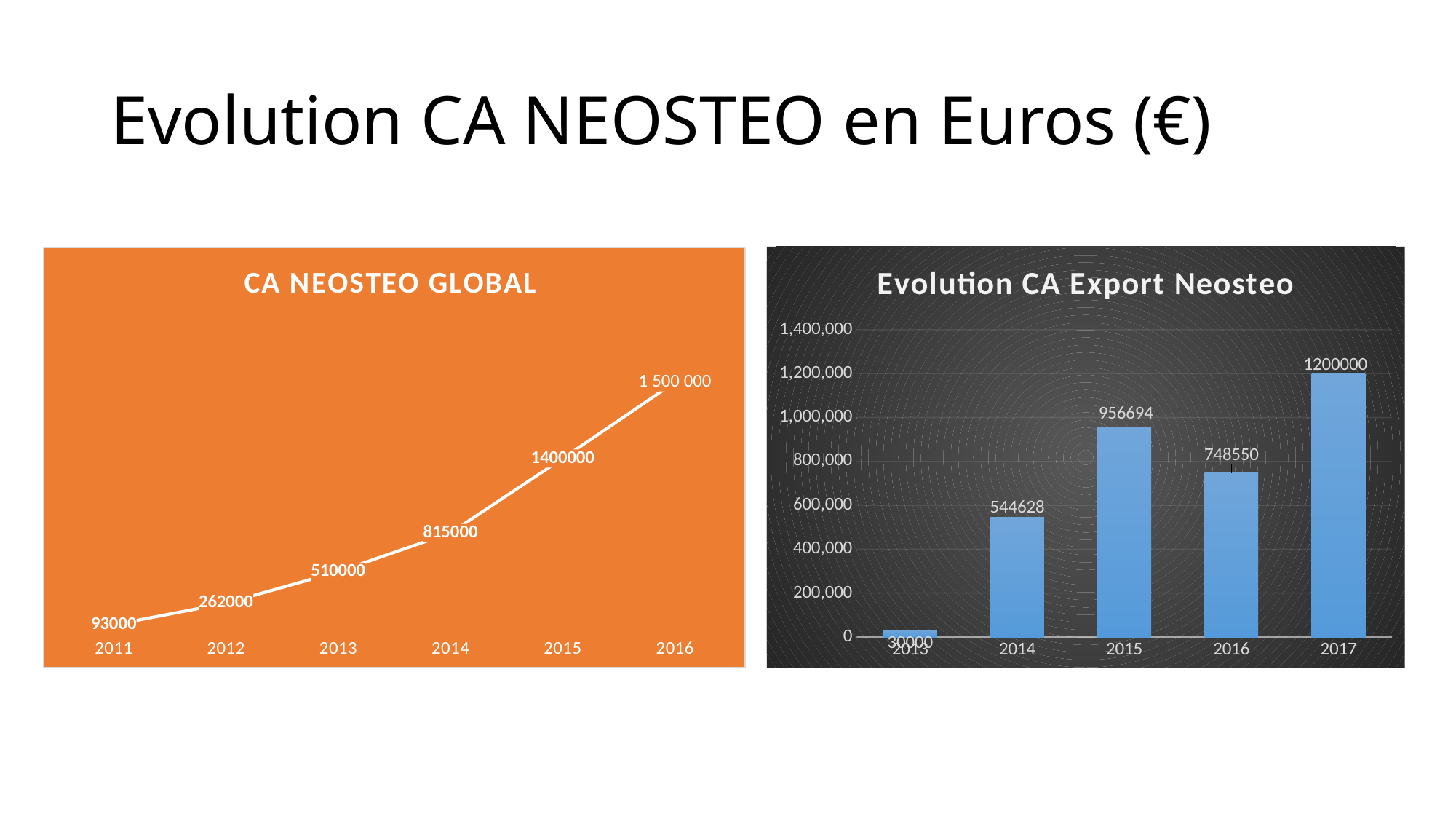
In the 'Evolution CA Export Neosteo' chart, what is the value for 2015? 956694 In the 'CA NEOSTEO GLOBAL' chart, what is the value for 2016? 1 500 000 In the 'CA NEOSTEO GLOBAL' chart, which year has the lowest value? 2011 In the 'Evolution CA Export Neosteo' chart, which year has the highest value? 2017 In the 'Evolution CA Export Neosteo' chart, what is the difference between the 2017 and 2016 values? 451450 What kind of chart is 'Evolution CA Export Neosteo'? bar chart How many years are plotted in the 'CA NEOSTEO GLOBAL' chart? 6 In the 'CA NEOSTEO GLOBAL' chart, what is the value for 2013? 510000 In the 'Evolution CA Export Neosteo' chart, which is larger, the value for 2014 or the value for 2016? 2016 In the 'CA NEOSTEO GLOBAL' chart, do the values rise or fall from 2011 to 2016? rise What kind of chart is 'CA NEOSTEO GLOBAL'? line chart In the 'CA NEOSTEO GLOBAL' chart, what is the difference between the 2015 and 2014 values? 585000